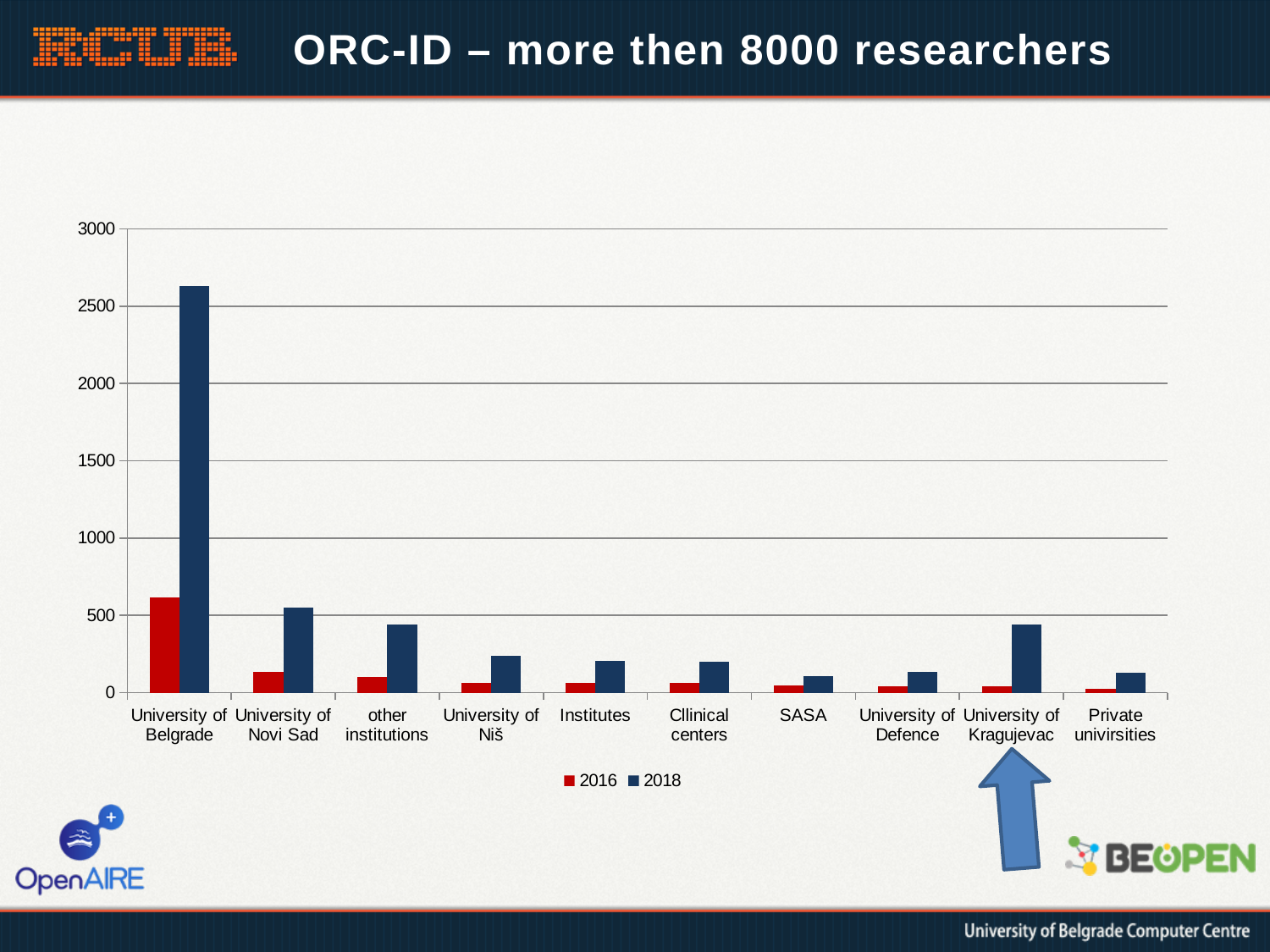
Is the 2018 value for University of Belgrade greater or less than 2500? greater Which category has the highest value for 2018? University of Belgrade Which colour represents the 2016 series in the chart legend? red Is the 2018 value for University of Novi Sad greater or less than 1000? less Which is larger for 2018: University of Belgrade or University of Novi Sad? University of Belgrade Is the 2018 value for University of Kragujevac greater or less than 500? less Which category has the highest value for 2016? University of Belgrade What kind of chart is shown on the slide? bar chart How many categories are shown on the x axis of the chart? 10 How many series does the chart legend list? 2 Which is larger for 2018: University of Kragujevac or University of Niš? University of Kragujevac